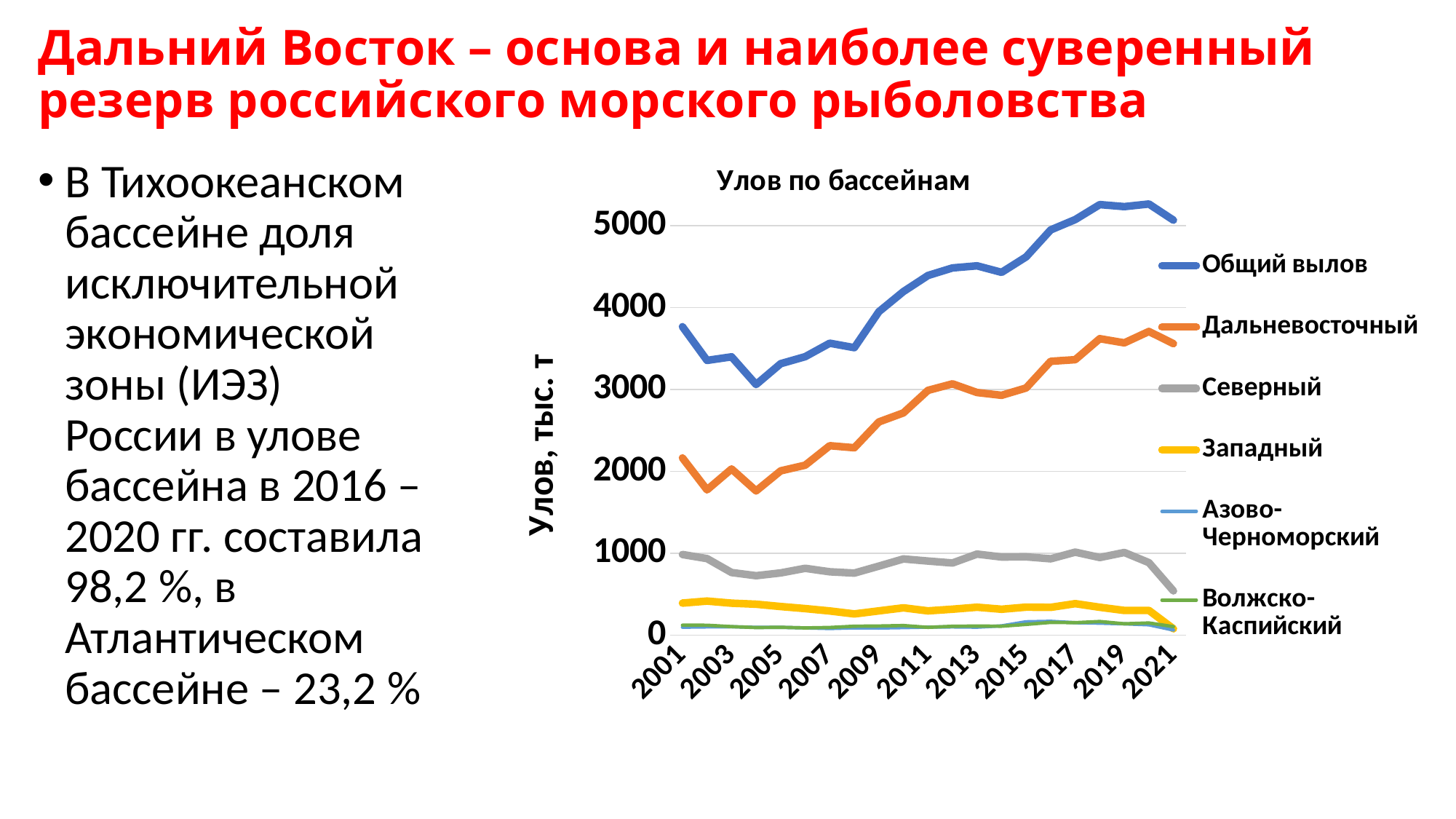
Does the Общий вылов line generally rise or fall between 2005 and 2019? rise How many series does the legend of the chart list? 6 Is the value of Северный in 2021 greater or less than 1000? less Is the value of Общий вылов in 2001 greater or less than 4000? less Does the Северный line rise or fall between 2019 and 2021? fall Is the value of Общий вылов in 2019 greater or less than 5000? greater Which series has the highest values throughout the chart? Общий вылов What is the label of the vertical axis of the chart? Улов, тыс. т What kind of chart is shown on the slide? line chart What is the title of the chart? Улов по бассейнам In 2019, which is larger: Дальневосточный or Северный? Дальневосточный